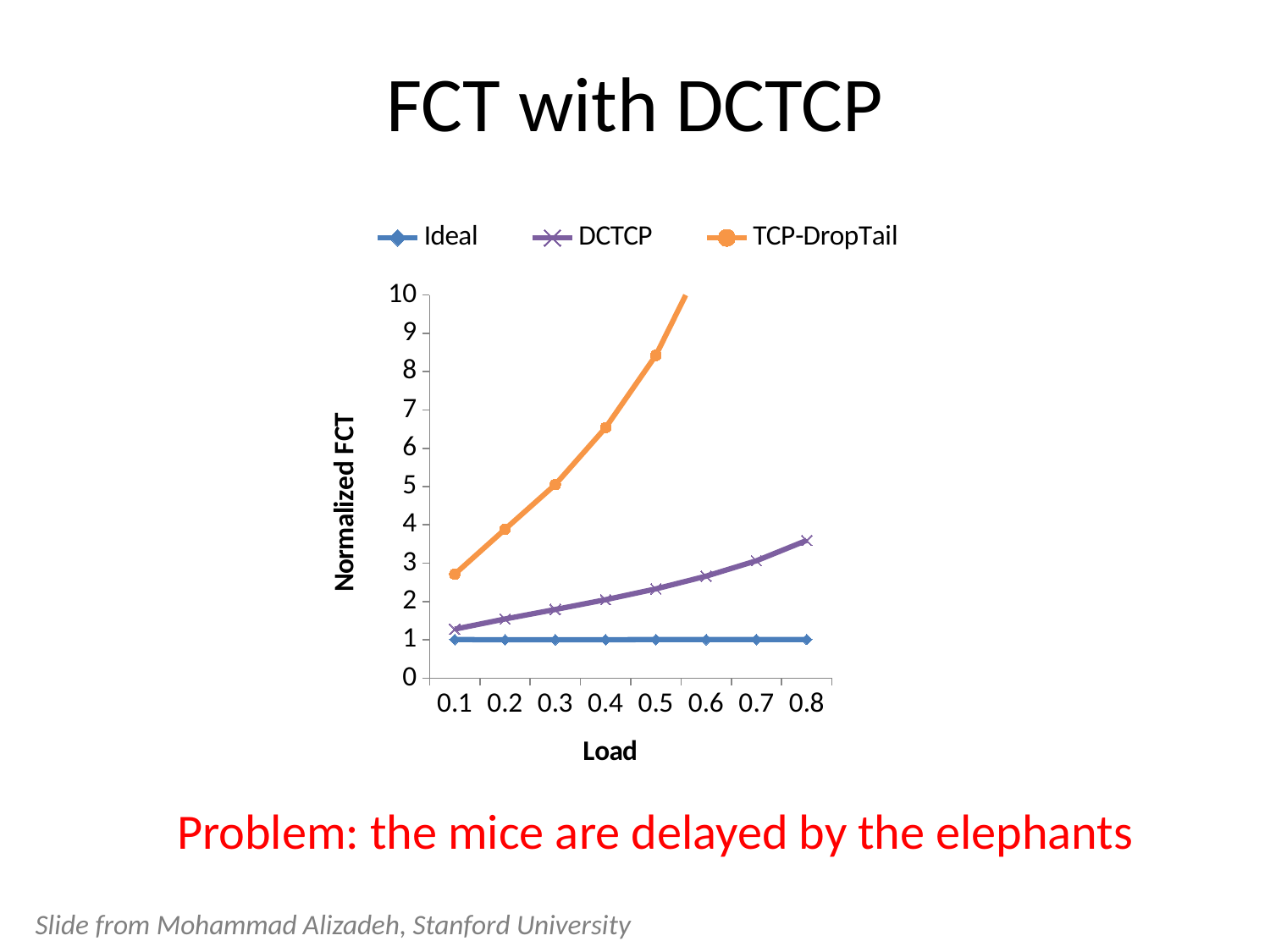
Which series has the lowest value at load 0.3? Ideal Is the value for DCTCP at load 0.1 greater or less than 2? less At load 0.4, which series has the larger value, TCP-DropTail or DCTCP? TCP-DropTail What is the label on the y axis? Normalized FCT What is the Normalized FCT for the Ideal series at load 0.8? 1 How many load values are marked on the x axis? 8 How many series does the legend list? 3 Is the value for TCP-DropTail at load 0.5 greater or less than 8? greater Is the value for DCTCP at load 0.8 greater or less than 3? greater Does the DCTCP series rise or fall as load increases? rise What is the Normalized FCT for the Ideal series at load 0.1? 1 What kind of chart is shown on the slide? line chart